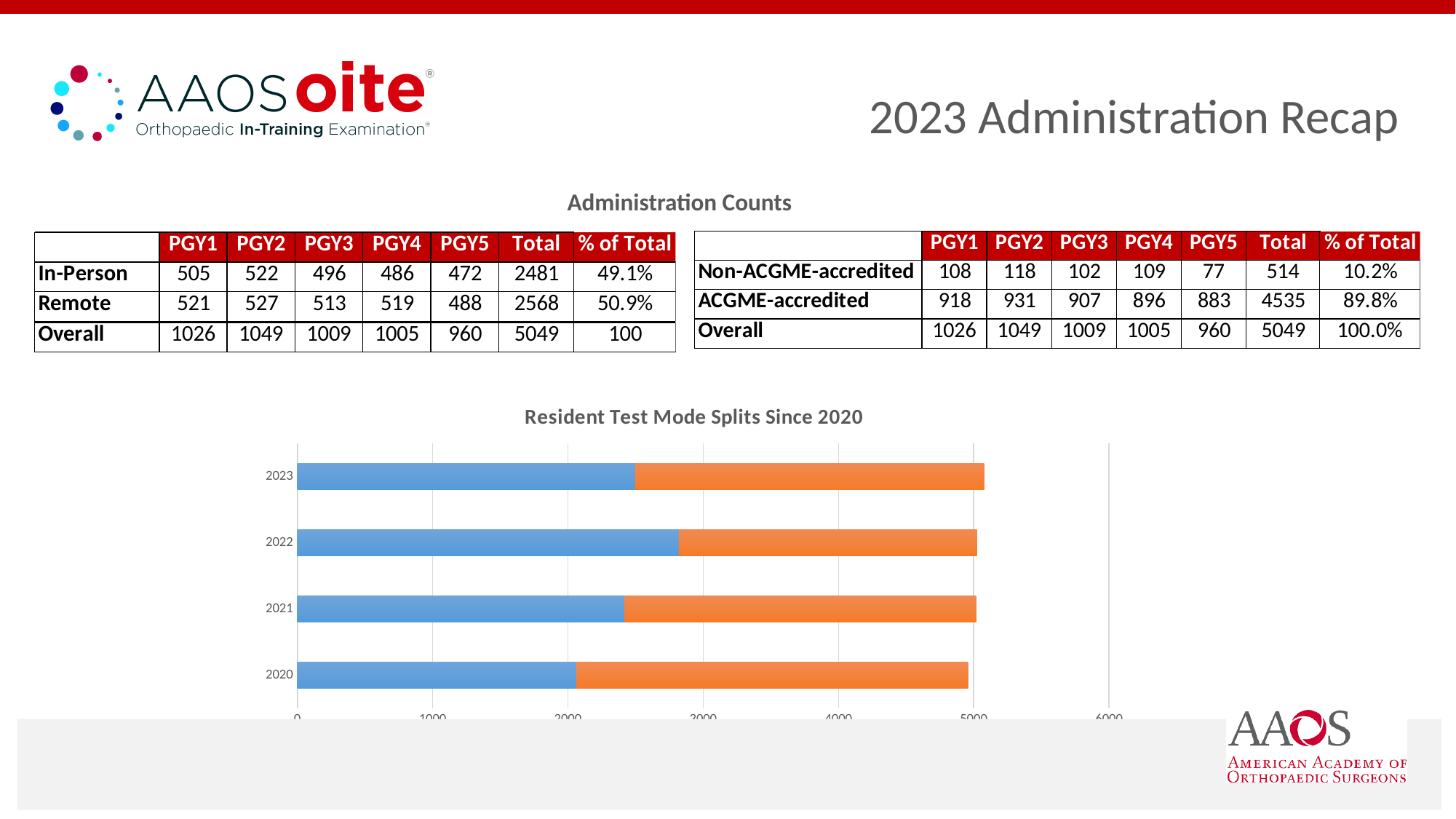
In the "Resident Test Mode Splits Since 2020" chart, is the blue segment for 2022 greater or less than 3000? less In the "Resident Test Mode Splits Since 2020" chart, is the blue segment for 2020 greater or less than 3000? less How many years are shown on the "Resident Test Mode Splits Since 2020" chart? 4 What kind of chart is "Resident Test Mode Splits Since 2020"? bar chart In the "Resident Test Mode Splits Since 2020" chart, is the total bar length for 2023 greater or less than 4000? greater In the "Resident Test Mode Splits Since 2020" chart, which year has the longest blue segment? 2022 What is the highest tick value shown on the horizontal axis of the "Resident Test Mode Splits Since 2020" chart? 6000 In the "Resident Test Mode Splits Since 2020" chart, which year has the shortest blue segment? 2020 In the "Resident Test Mode Splits Since 2020" chart, is the blue segment larger for 2022 or for 2020? 2022 What is the title of the bar chart on the slide? Resident Test Mode Splits Since 2020